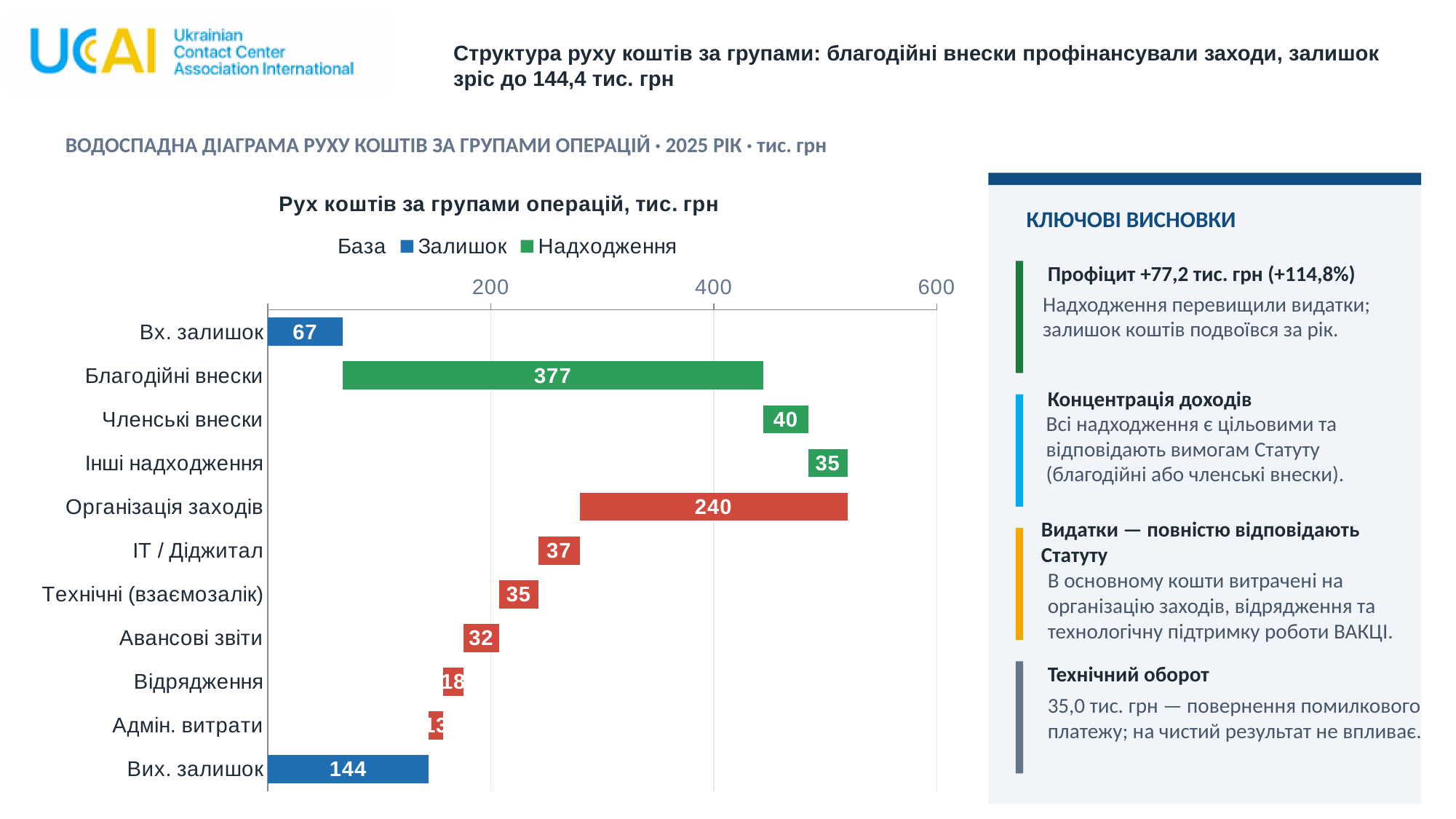
What is the value for Відрядження in the chart? 18 How many categories are shown on the vertical axis of the chart? 11 Which is larger, the value for Членські внески or the value for ІТ / Діджитал? Членські внески What is the value for Вих. залишок in the chart? 144 What kind of chart is shown on the slide? Bar chart (waterfall) What is the value for Благодійні внески in the chart? 377 Which category has the highest value in the chart? Благодійні внески What is the difference between the values for Вих. залишок and Вх. залишок? 77 How many entries does the chart legend list? 3 Which category has the lowest value in the chart? Адмін. витрати What is the title of the chart? Рух коштів за групами операцій, тис. грн What is the value for Організація заходів in the chart? 240